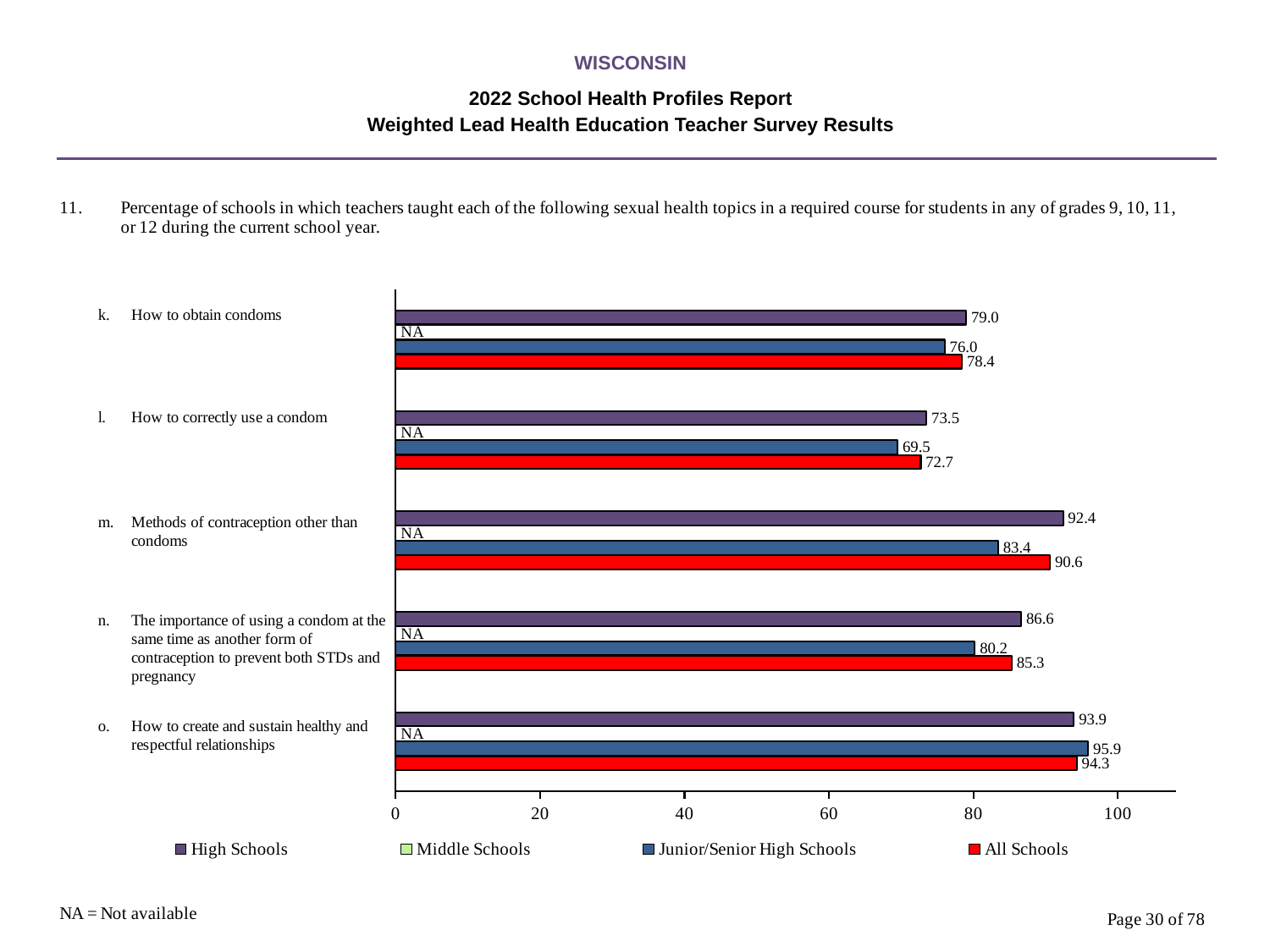
What is the difference between the High Schools and Junior/Senior High Schools values for 'Methods of contraception other than condoms'? 9.0 How many series does the legend list? 4 Which topic has the lowest value for All Schools? How to correctly use a condom What is the value for High Schools for 'How to obtain condoms'? 79.0 What is the value for All Schools for 'How to correctly use a condom'? 72.7 What kind of chart is shown? bar chart What is the value for Middle Schools for 'How to create and sustain healthy and respectful relationships'? NA For 'How to create and sustain healthy and respectful relationships', which is larger: High Schools or Junior/Senior High Schools? Junior/Senior High Schools Which topic has the highest value for High Schools? How to create and sustain healthy and respectful relationships How many topics are shown on the chart? 5 Is the Junior/Senior High Schools value for 'How to correctly use a condom' greater or less than 80? less What is the value for Junior/Senior High Schools for 'Methods of contraception other than condoms'? 83.4